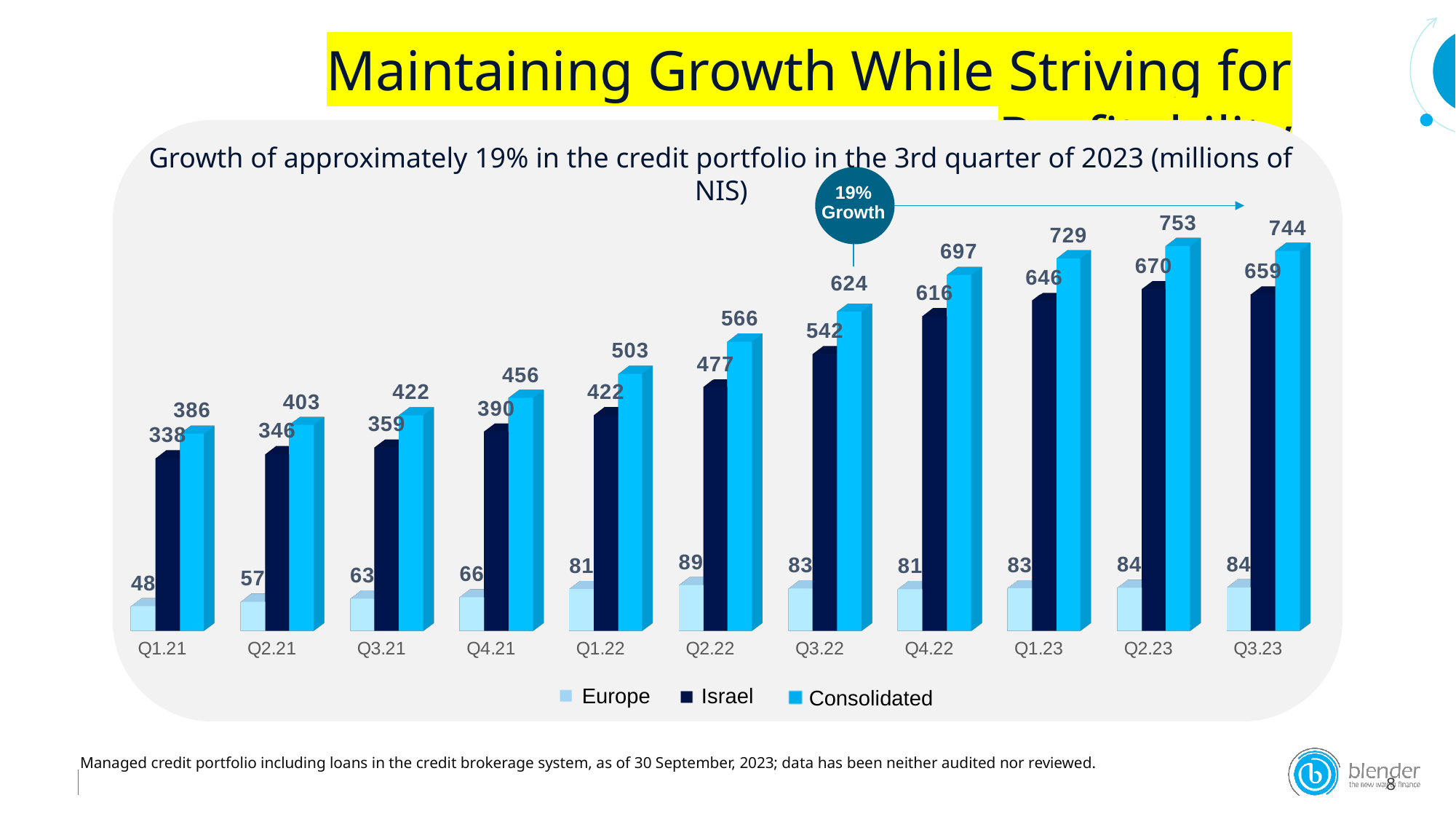
In which quarter is the Consolidated value highest? Q2.23 What is the Consolidated value for Q3.23? 744 How many quarters are shown on the x axis? 11 How many series does the legend list? 3 In which quarter is the Israel value lowest? Q1.21 What is the Europe value for Q1.21? 48 Which series is shown in the darkest colour in the legend? Israel Which is larger, the Israel value for Q2.23 or the Israel value for Q3.23? Q2.23 Do the Consolidated values generally rise or fall from Q1.21 to Q2.23? Rise What is the Israel value for Q2.22? 477 What kind of chart is shown on the slide? Bar chart What is the difference between the Consolidated values for Q3.23 and Q3.22? 120